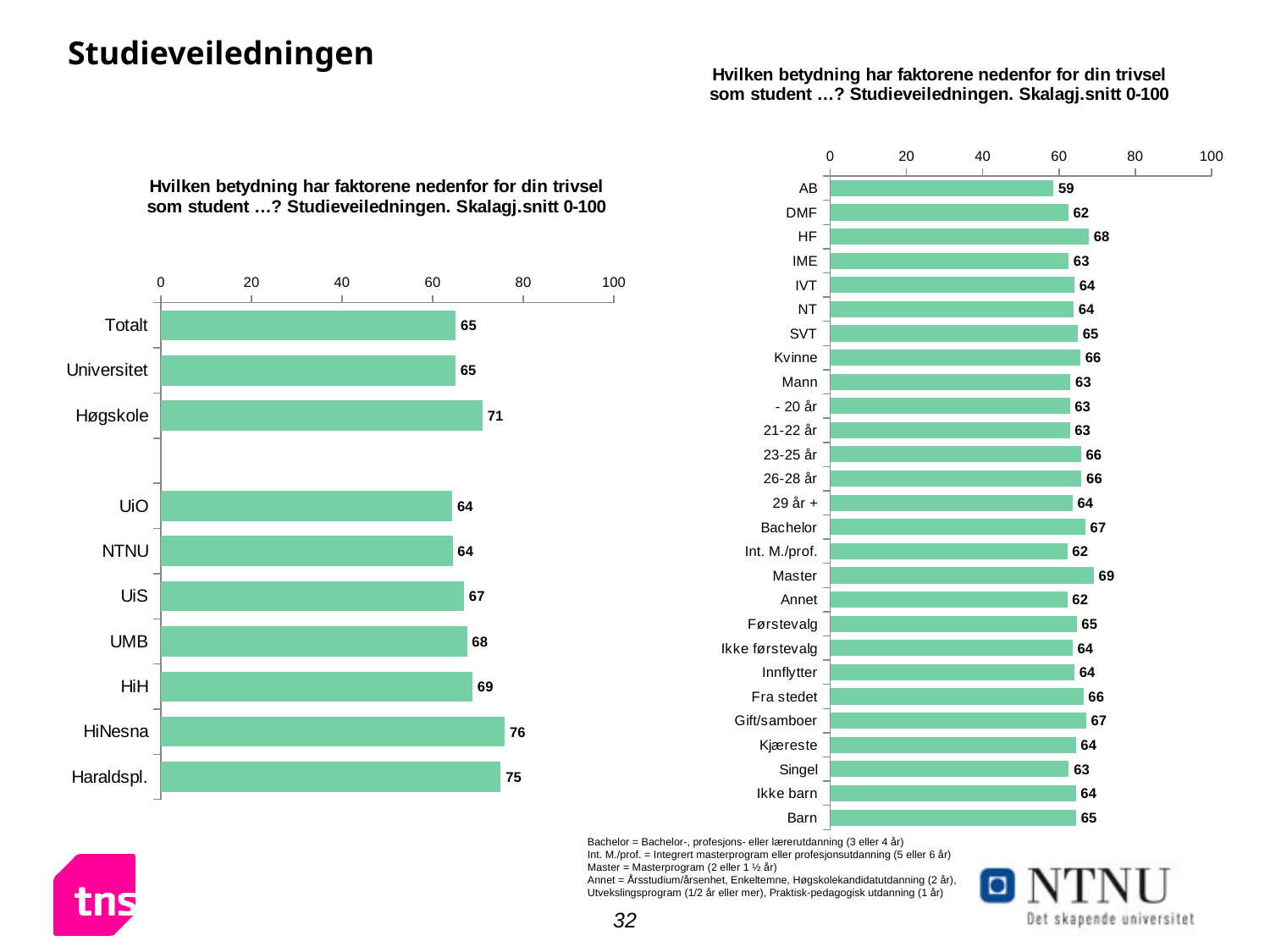
In the right chart, which category has the highest value? Master In the left chart, what is the difference between HiNesna and Haraldspl.? 1 What kind of chart is the left chart? bar chart In the left chart, what is the value for Høgskole? 71 In the left chart, how many categories are plotted? 10 In the right chart, is the value for Kvinne greater or less than 60? greater In the right chart, what is the difference between HF and AB? 9 In the right chart, how many categories are plotted? 27 In the left chart, which is larger, the value for UiS or the value for NTNU? UiS In the right chart, what is the value for Master? 69 In the left chart, which category has the highest value? HiNesna In the right chart, which category has the lowest value? AB